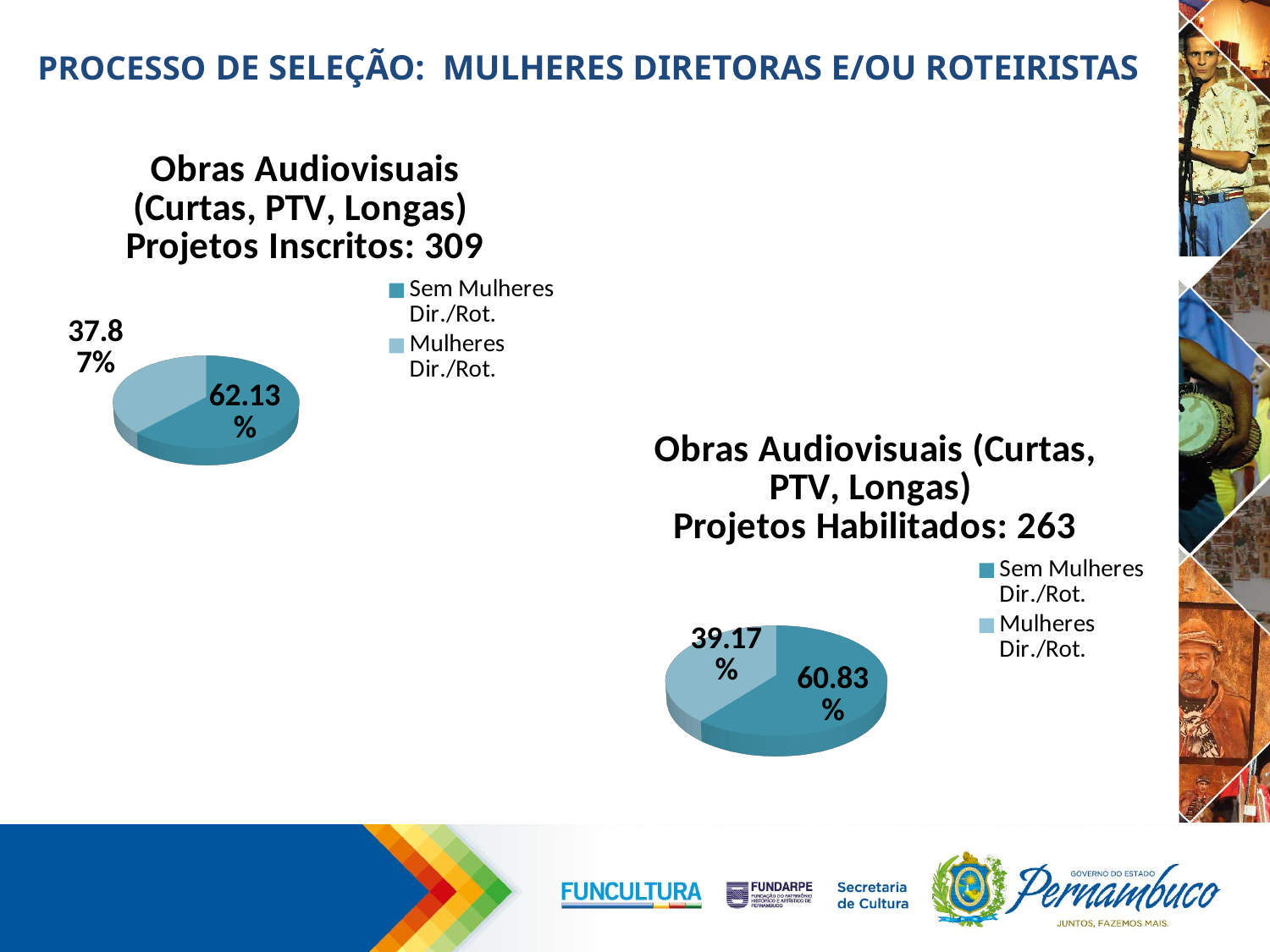
How many pie charts are shown on the slide? 2 How many entries does the legend of the 'Projetos Habilitados: 263' pie chart list? 2 What kind of chart is the 'Projetos Inscritos: 309' chart on the left? Pie chart In the 'Projetos Inscritos: 309' pie chart, what share is labelled for 'Sem Mulheres Dir./Rot.'? 62.13% In the 'Projetos Habilitados: 263' pie chart, what share is labelled for 'Mulheres Dir./Rot.'? 39.17% Which chart shows a larger share for 'Mulheres Dir./Rot.': 'Projetos Inscritos: 309' or 'Projetos Habilitados: 263'? Projetos Habilitados: 263 In the 'Projetos Inscritos: 309' pie chart, what share is labelled for 'Mulheres Dir./Rot.'? 37.87% How many slices does the 'Projetos Inscritos: 309' pie chart have? 2 In the 'Projetos Inscritos: 309' pie chart, which slice is the largest? Sem Mulheres Dir./Rot. In the 'Projetos Habilitados: 263' pie chart, what is the difference between the 'Sem Mulheres Dir./Rot.' and 'Mulheres Dir./Rot.' shares? 21.66% In the 'Projetos Habilitados: 263' pie chart, which slice is the smallest? Mulheres Dir./Rot.